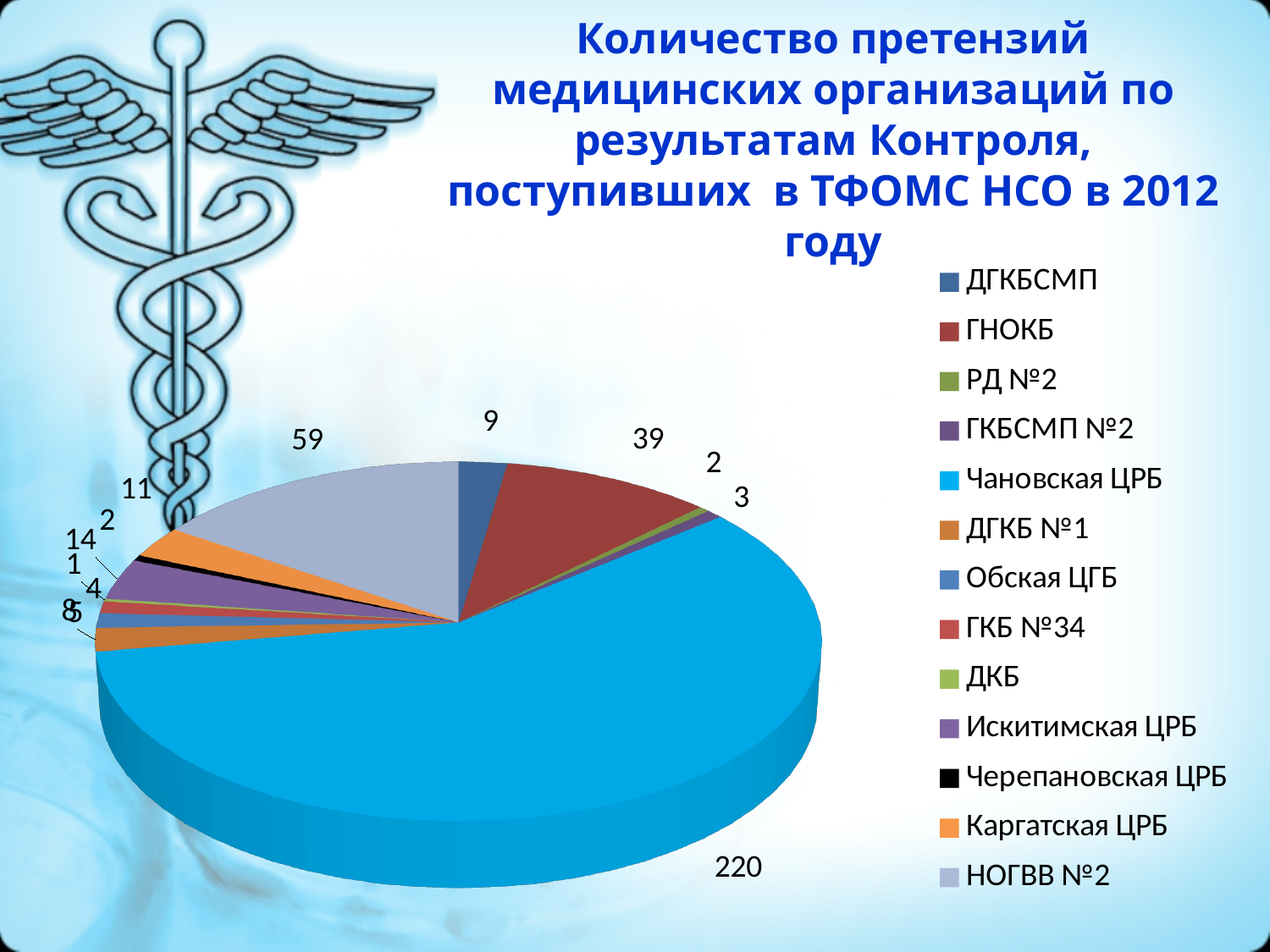
Which organisation has the largest slice of the pie? Чановская ЦРБ Which has more claims, НОГВВ №2 or ГНОКБ? НОГВВ №2 How many claims are shown for Искитимская ЦРБ? 14 How many claims are shown for ДГКБСМП? 9 How many claims are shown for НОГВВ №2? 59 What colour is the slice for Чановская ЦРБ? light blue How many claims are shown for ГНОКБ? 39 How many claims are shown for Чановская ЦРБ? 220 How many organisations does the legend list? 13 What is the difference between the values for Чановская ЦРБ and ГНОКБ? 181 What kind of chart is shown on the slide? pie chart How many claims are shown for Каргатская ЦРБ? 11